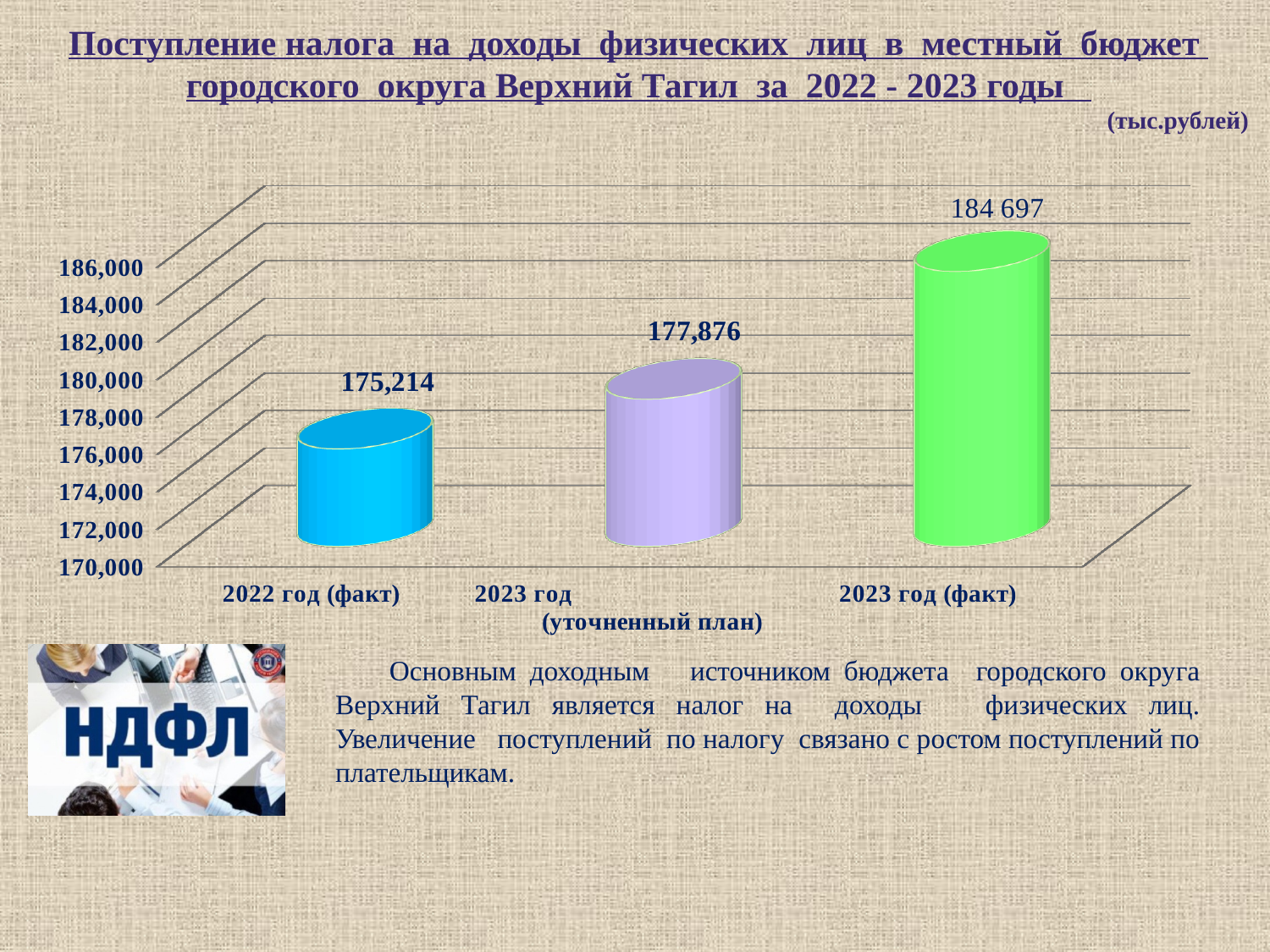
What kind of chart is shown on the slide? bar chart What is the difference between the values for 2023 год (факт) and 2022 год (факт)? 9,483 Is the value for 2023 год (факт) greater or less than 180,000? greater Which category has the highest value? 2023 год (факт) What is the difference between the values for 2023 год (уточненный план) and 2022 год (факт)? 2,662 What is the value for 2022 год (факт)? 175,214 Do the values rise or fall from left to right across the categories? rise Which is larger: the value for 2023 год (уточненный план) or 2023 год (факт)? 2023 год (факт) How many categories are shown in the chart? 3 What is the value for 2023 год (уточненный план)? 177,876 Which category has the lowest value? 2022 год (факт) What is the value for 2023 год (факт)? 184 697